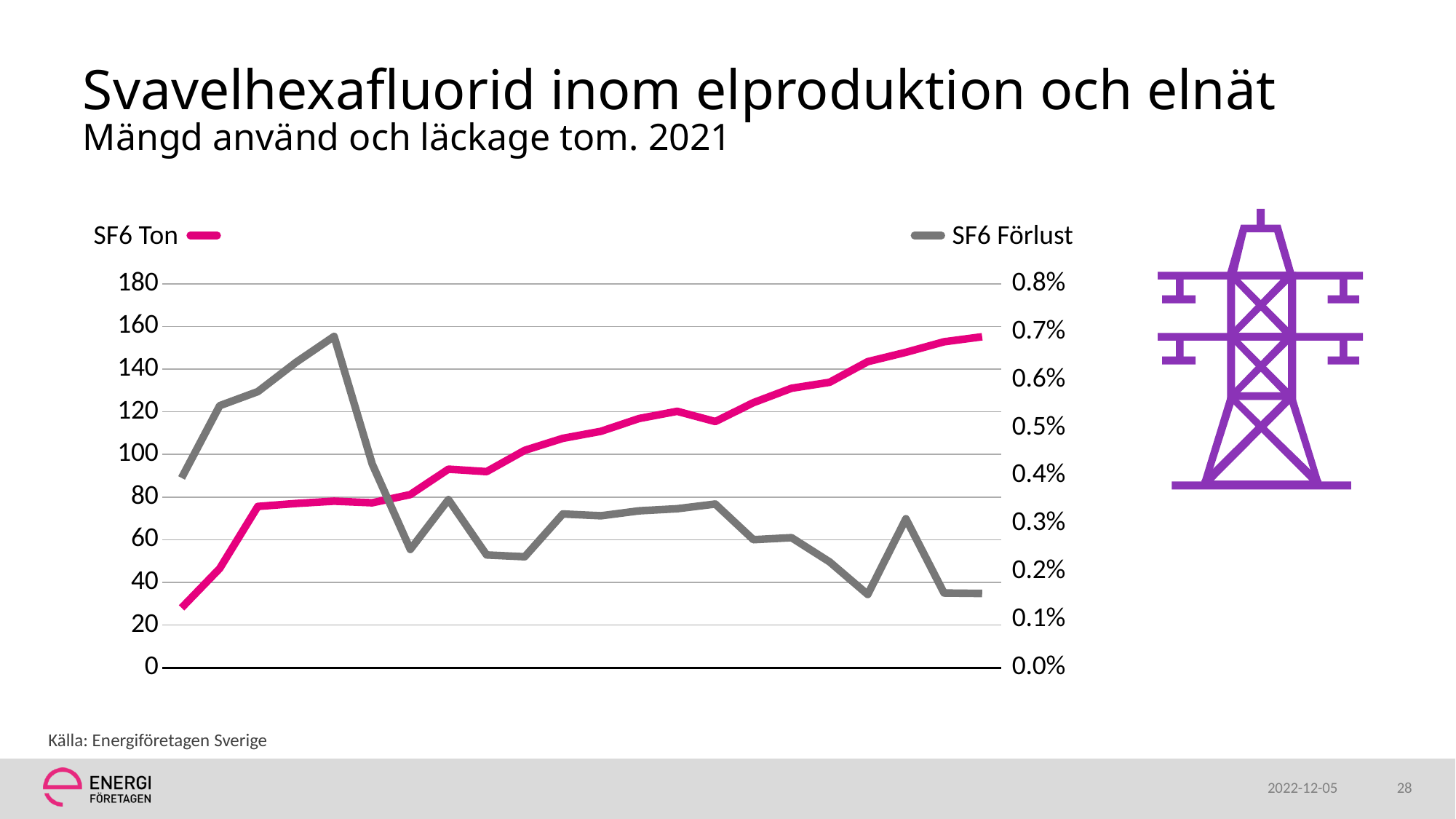
How many series does the chart's legend list? 2 Which colour is used for the SF6 Ton series? pink Is the highest value of the SF6 Förlust series greater or less than 0.6%? greater Is the first value of the SF6 Ton series greater or less than 40? less What is the maximum value shown on the left vertical axis? 180 What kind of chart is shown on the slide? line chart Is the final value of the SF6 Förlust series greater or less than 0.2%? less Is the last value of the SF6 Ton series greater or less than its first value? greater What are the two series named in the chart's legend? SF6 Ton and SF6 Förlust Does the SF6 Förlust series generally rise or fall over the later part of the chart, after its peak? fall Does the SF6 Ton series generally rise or fall from left to right? rise